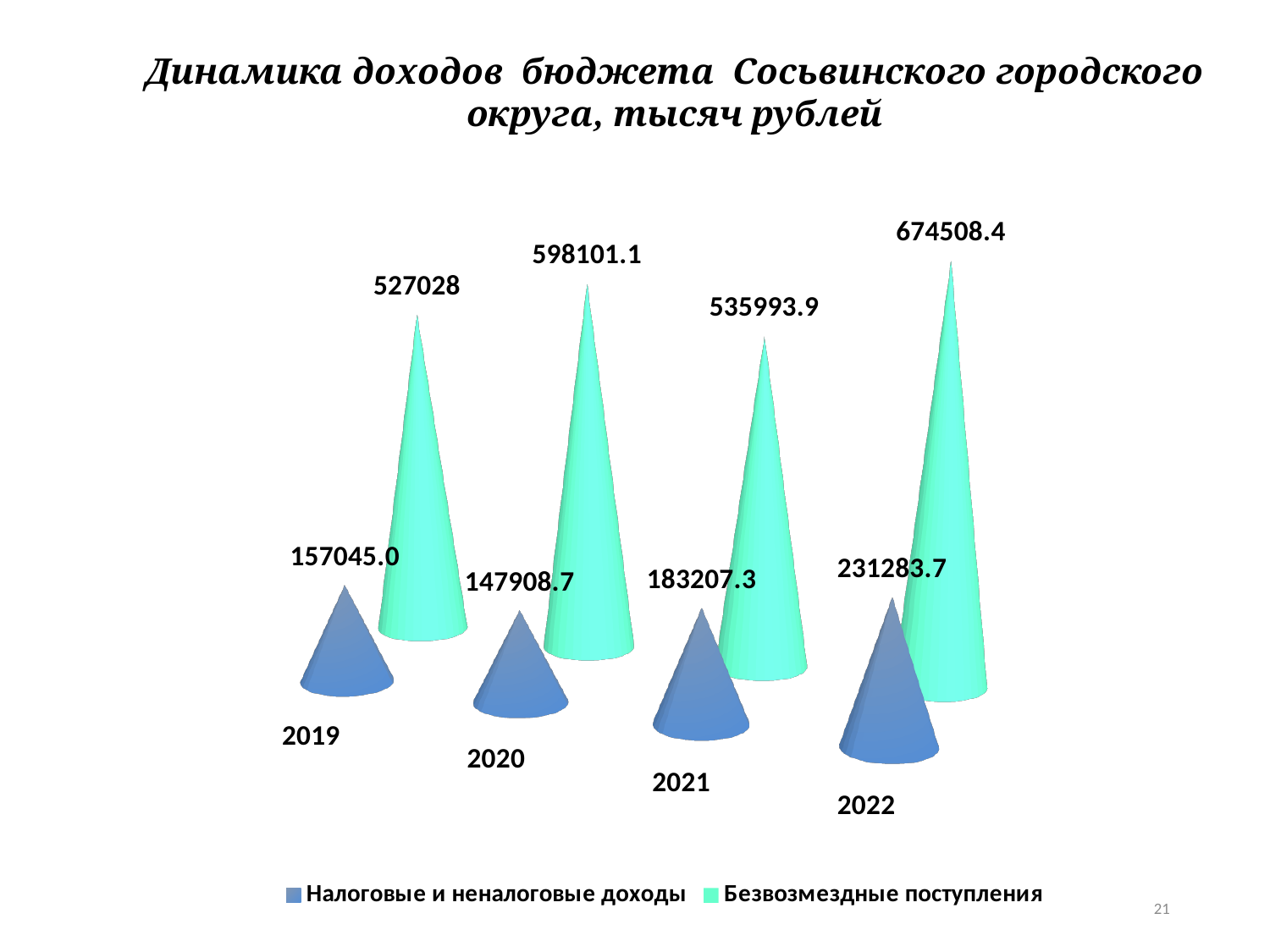
In which year is the value for Безвозмездные поступления the lowest? 2019 Which is larger: Безвозмездные поступления in 2020 or in 2021? 2020 What is the difference between the Налоговые и неналоговые доходы values for 2022 and 2021? 48076.4 How many years are shown on the x axis? 4 What is the value for Безвозмездные поступления in 2019? 527028 What kind of chart is shown on the slide? Bar chart What is the value for Безвозмездные поступления in 2022? 674508.4 Between 2020 and 2022, do the values for Налоговые и неналоговые доходы rise or fall? Rise In which year is the value for Налоговые и неналоговые доходы the highest? 2022 What is the total of Налоговые и неналоговые доходы and Безвозмездные поступления for 2022? 905792.1 What is the value for Налоговые и неналоговые доходы in 2020? 147908.7 How many series does the legend list? 2